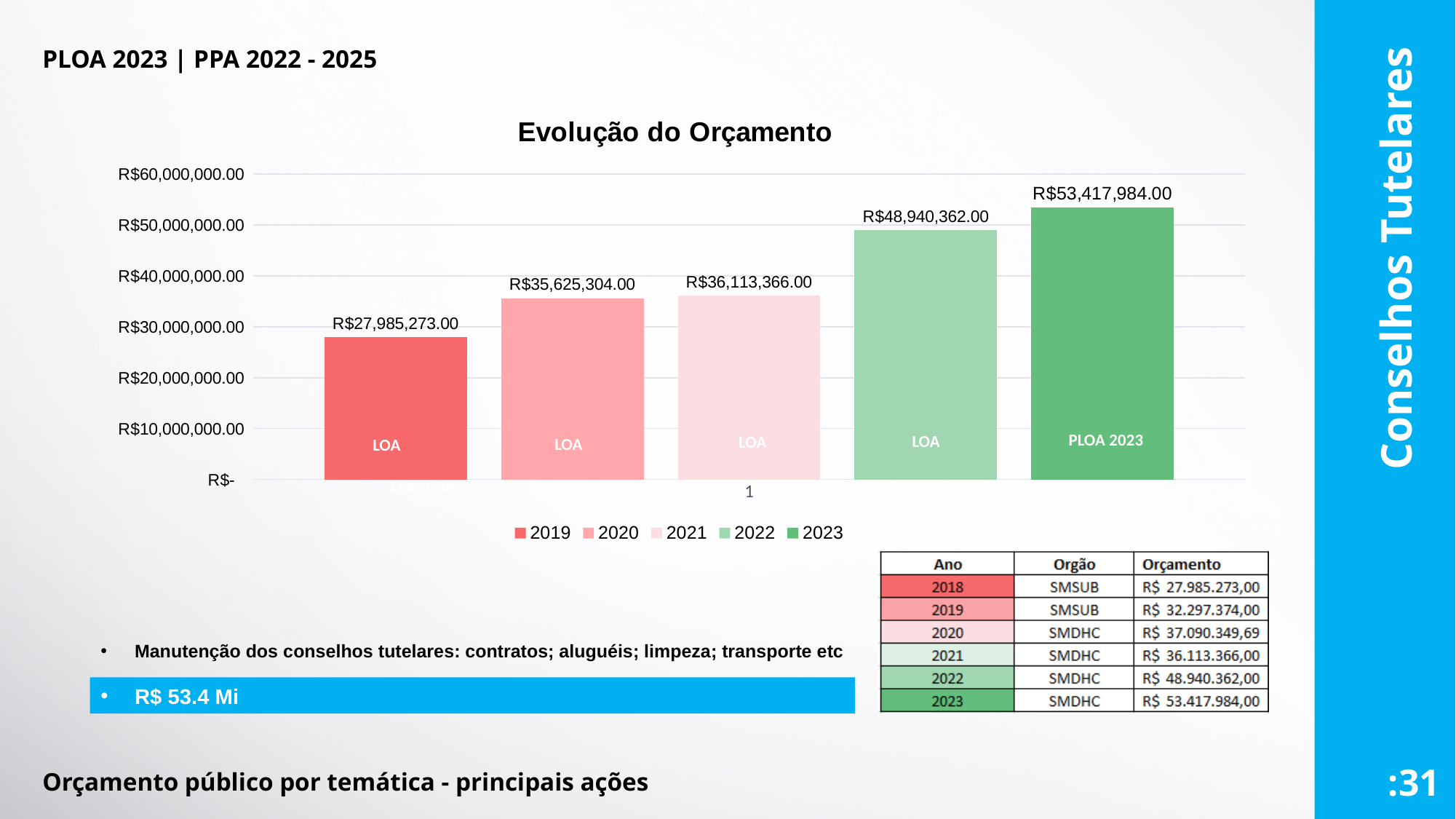
What is the value of the 2022 bar in the "Evolução do Orçamento" chart? R$48,940,362.00 What is the value of the 2023 bar in the "Evolução do Orçamento" chart? R$53,417,984.00 Which series has the lowest value in the "Evolução do Orçamento" chart? 2019 What label is printed inside the 2023 bar in the "Evolução do Orçamento" chart? PLOA 2023 What is the difference between the 2021 and 2020 values in the "Evolução do Orçamento" chart? R$488,062.00 What is the value of the 2019 bar in the "Evolução do Orçamento" chart? R$27,985,273.00 How many series does the legend of the "Evolução do Orçamento" chart list? 5 What type of chart is shown under the title "Evolução do Orçamento"? bar chart Do the values in the "Evolução do Orçamento" chart rise or fall from left to right? rise In the "Evolução do Orçamento" chart, which is larger, the 2022 value or the 2021 value? 2022 Which series has the highest value in the "Evolução do Orçamento" chart? 2023 What is the difference between the 2023 and 2022 values in the "Evolução do Orçamento" chart? R$4,477,622.00